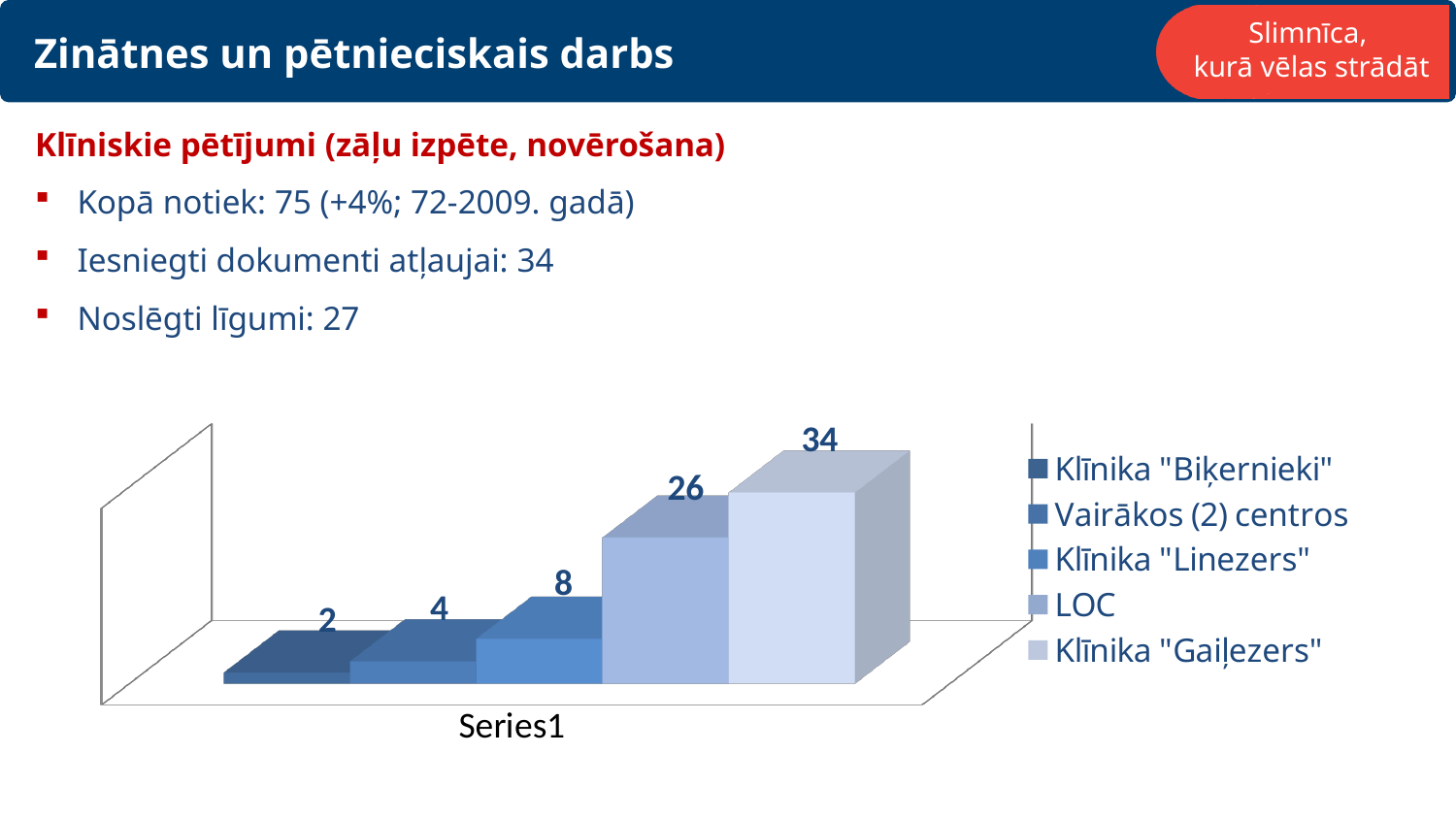
What is the value for Klīnika "Linezers"? 8 Which is larger, the value for LOC or the value for Klīnika "Linezers"? LOC How many series does the chart legend list? 5 Which series has the highest value? Klīnika "Gaiļezers" Which series has the lowest value? Klīnika "Biķernieki" What is the value for Klīnika "Gaiļezers"? 34 What is the value for Klīnika "Biķernieki"? 2 What is the difference between the values for Klīnika "Gaiļezers" and LOC? 8 What kind of chart is shown on the slide? bar chart What is the category label shown on the x axis of the chart? Series1 What is the value for Vairākos (2) centros? 4 What is the value for LOC? 26